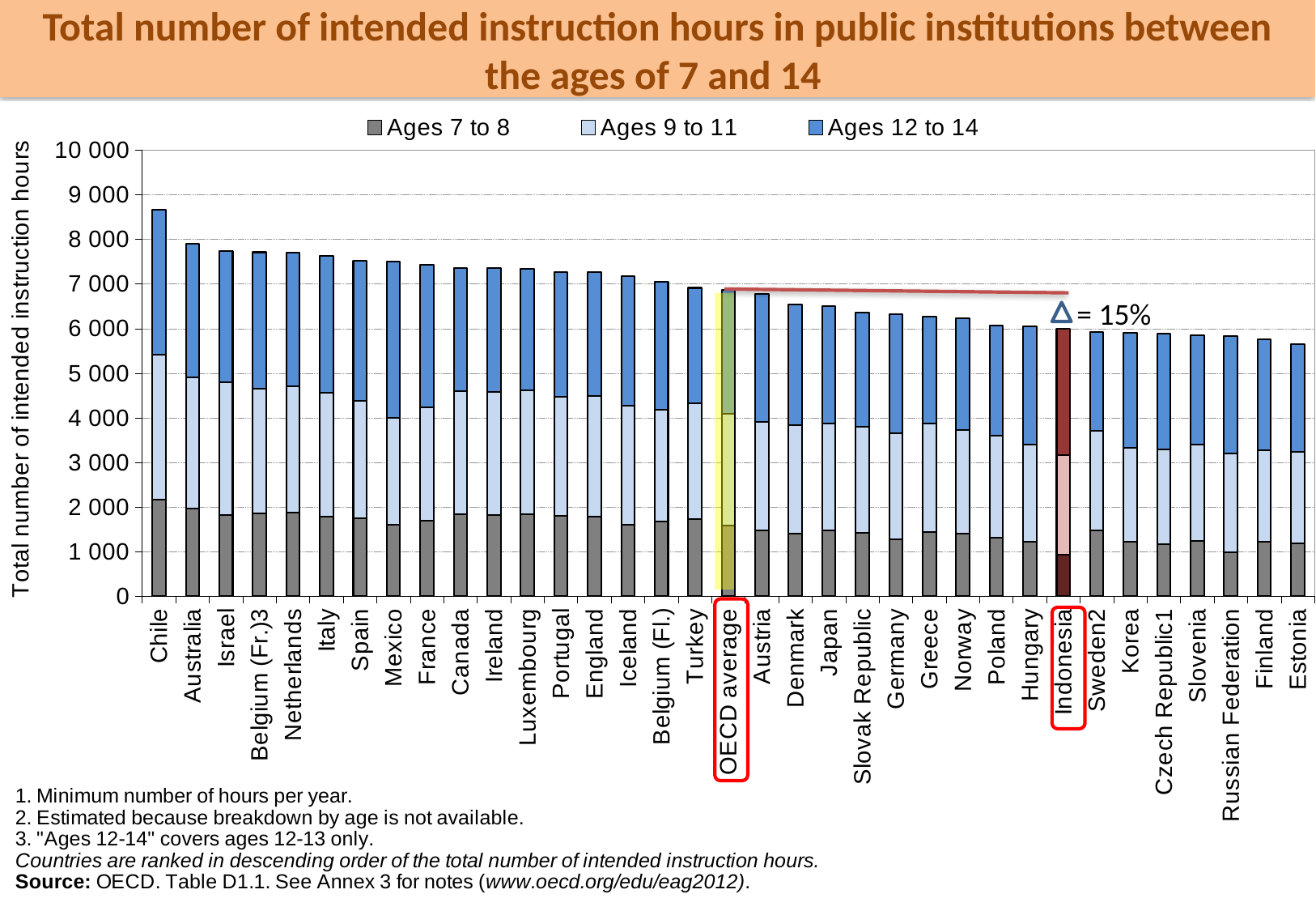
What kind of chart is shown on the slide? Stacked bar chart Do the total bar heights rise or fall from left to right along the x axis? Fall How many series does the legend list? 3 Which country has the lowest total number of intended instruction hours? Estonia How many categories (countries and averages) are shown on the x axis? 35 Which has a larger total of intended instruction hours, Chile or Estonia? Chile Is the total for Estonia greater or less than 6 000? less Is the total for Austria greater or less than 7 000? less Is the total for Chile greater or less than 8 000? greater Which country has the highest total number of intended instruction hours? Chile What percentage difference is annotated between the OECD average and Indonesia? 15%